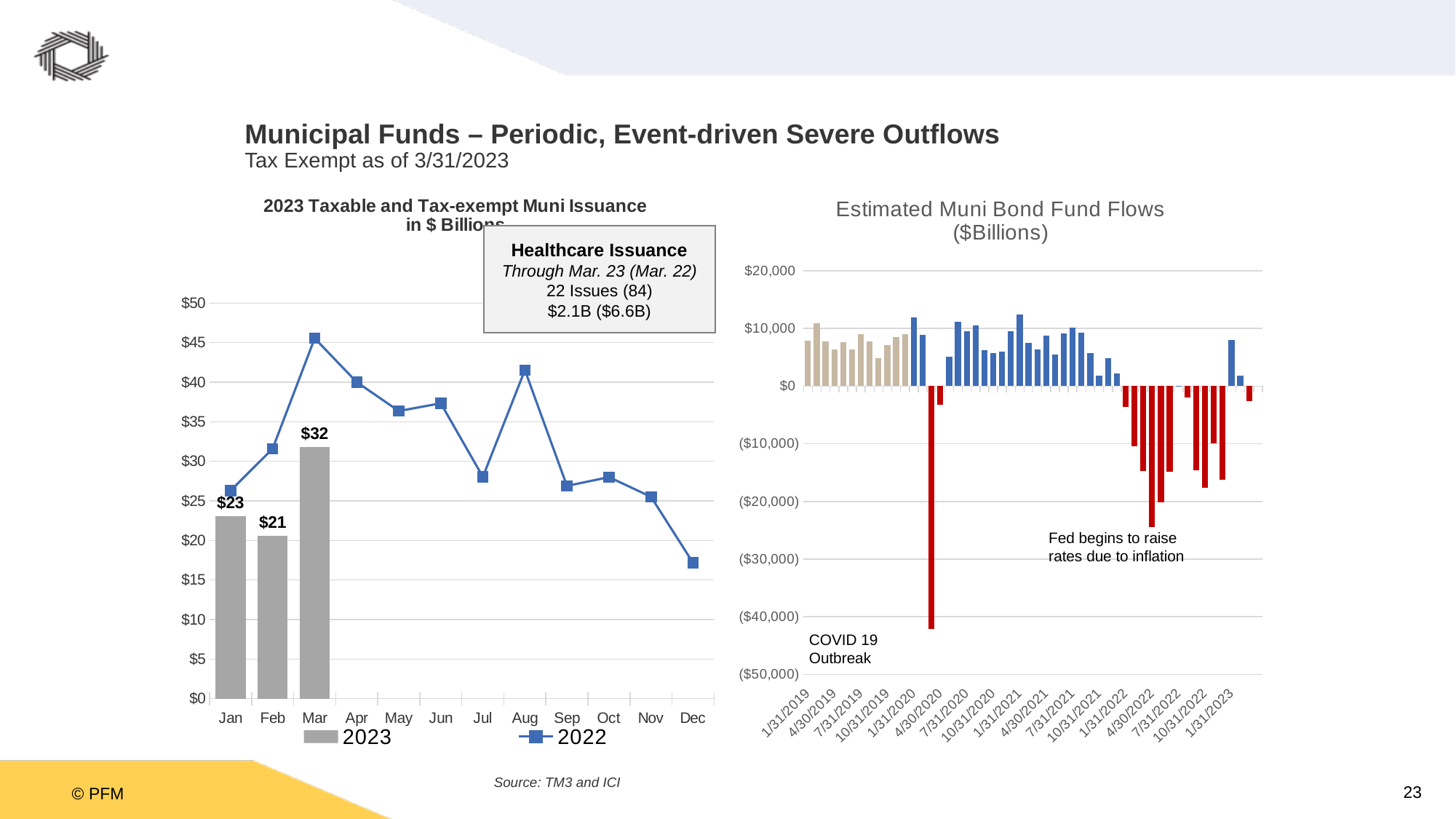
In the left chart (2023 Taxable and Tax-exempt Muni Issuance), which is larger, the 2023 value for Jan or for Feb? Jan What kind of chart is the right chart (Estimated Muni Bond Fund Flows)? bar chart In the left chart (2023 Taxable and Tax-exempt Muni Issuance), which month has the lowest 2023 issuance bar? Feb In the left chart (2023 Taxable and Tax-exempt Muni Issuance), which month has the highest 2023 issuance bar? Mar In the left chart (2023 Taxable and Tax-exempt Muni Issuance), is the 2022 value for Dec greater or less than $20? less In the left chart (2023 Taxable and Tax-exempt Muni Issuance), what is the difference between the 2023 values for Mar and Jan? $9 In the left chart (2023 Taxable and Tax-exempt Muni Issuance), is the 2022 value for Mar greater or less than $40? greater In the left chart (2023 Taxable and Tax-exempt Muni Issuance), how many series does the legend list? 2 In the left chart (2023 Taxable and Tax-exempt Muni Issuance), what is the 2023 issuance value for Feb? $21 In the left chart (2023 Taxable and Tax-exempt Muni Issuance), does the 2022 line rise or fall from Aug to Dec? fall In the right chart (Estimated Muni Bond Fund Flows), is the value for 4/30/2020 greater or less than ($30,000)? greater In the left chart (2023 Taxable and Tax-exempt Muni Issuance), what is the 2023 issuance value for Mar? $32